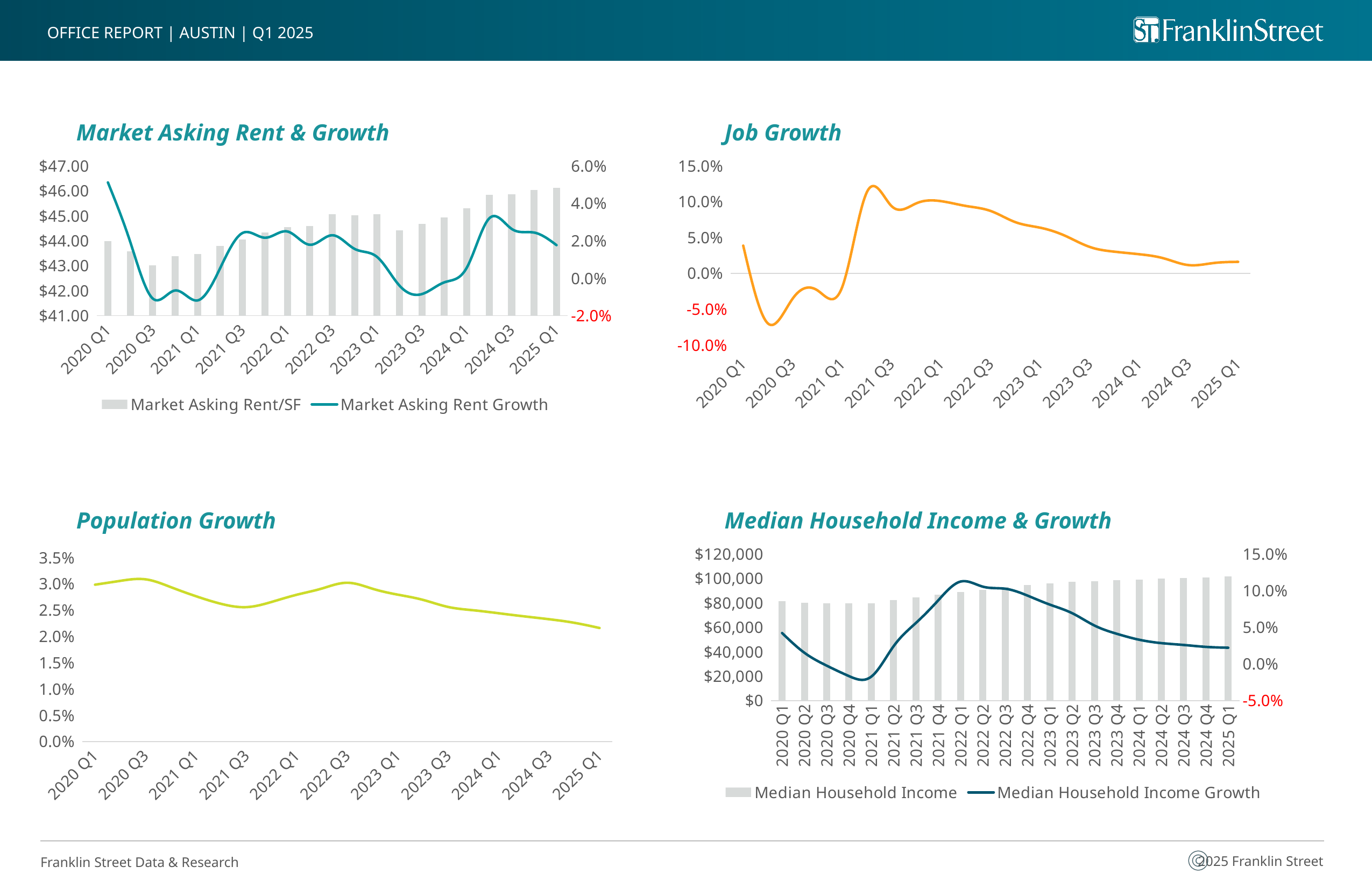
In the Median Household Income & Growth chart, is the Median Household Income Growth for 2022 Q1 greater or less than 10.0%? greater In the Job Growth chart, which quarter has the lowest job growth? 2020 Q2 What kind of chart is the Job Growth chart? line chart In the Market Asking Rent & Growth chart, is the Market Asking Rent/SF for 2020 Q3 greater or less than $44.00? less In the Population Growth chart, do values rise or fall overall from 2020 Q1 to 2025 Q1? fall In the Job Growth chart, which quarter has the highest job growth? 2021 Q2 In the Market Asking Rent & Growth chart, is the Market Asking Rent Growth for 2020 Q1 greater or less than 4.0%? greater In the Market Asking Rent & Growth chart, how many series does the legend list? 2 In the Median Household Income & Growth chart, how many quarters are plotted on the x axis? 21